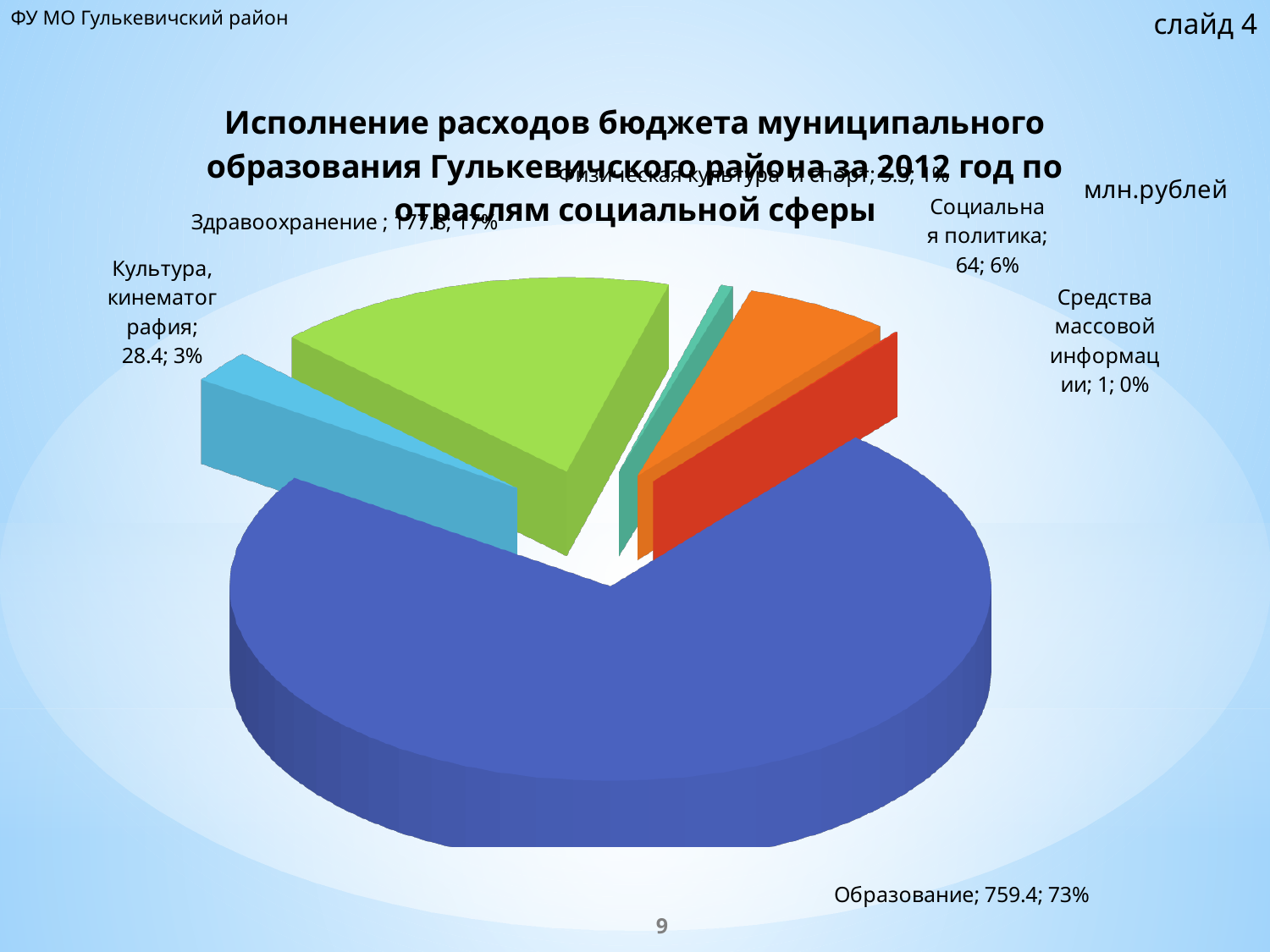
Which category has the largest slice of the pie? Образование What is the value for Культура, кинематография? 28.4 What is the difference between the values for Социальная политика and Культура, кинематография? 35.6 What is the value for Социальная политика? 64 What is the value for Средства массовой информации? 1 Which category has the smallest slice of the pie? Средства массовой информации What share of the pie does Социальная политика represent? 6% What is the value for Образование? 759.4 What share of the pie does Образование represent? 73% What kind of chart is shown on the slide? Pie chart Which is larger, the value for Социальная политика or the value for Культура, кинематография? Социальная политика How many categories (slices) does the pie chart have? 6